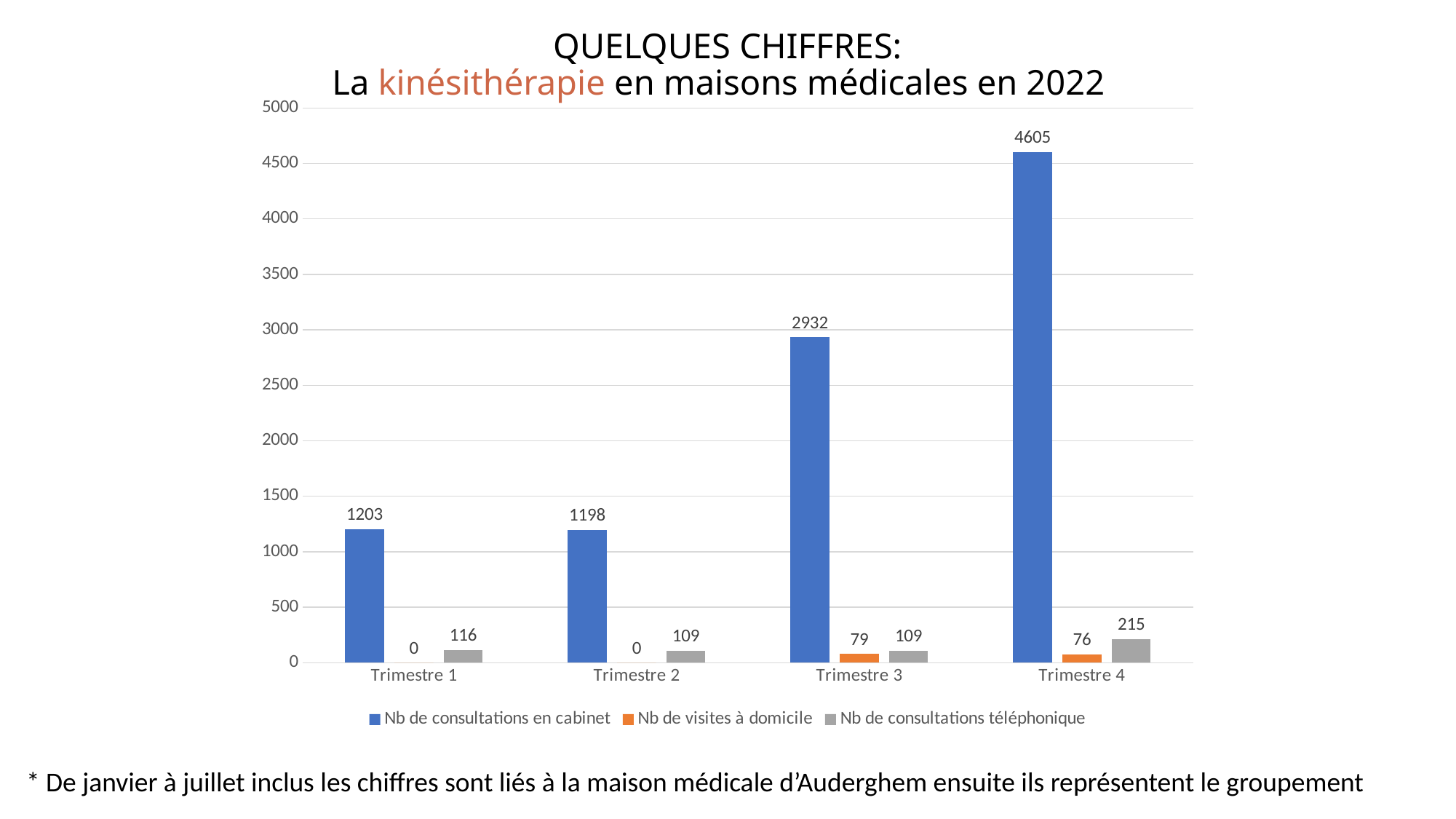
Which trimestre has the lowest number of 'Nb de consultations téléphonique'? Trimestre 2 and Trimestre 3 (109) How many trimestres are shown on the x axis? 4 How many series does the legend list? 3 What is the number of 'Nb de consultations en cabinet' for Trimestre 4? 4605 What is the difference in 'Nb de consultations en cabinet' between Trimestre 4 and Trimestre 3? 1673 Is the value of 'Nb de consultations en cabinet' for Trimestre 3 greater or less than 2500? greater What is the number of 'Nb de consultations téléphonique' for Trimestre 1? 116 Which is larger: 'Nb de visites à domicile' in Trimestre 3 or in Trimestre 4? Trimestre 3 What is the number of 'Nb de visites à domicile' for Trimestre 3? 79 Does 'Nb de consultations en cabinet' generally rise or fall from Trimestre 2 to Trimestre 4? Rise Which trimestre has the highest number of 'Nb de consultations en cabinet'? Trimestre 4 What kind of chart is shown on the slide? Bar chart